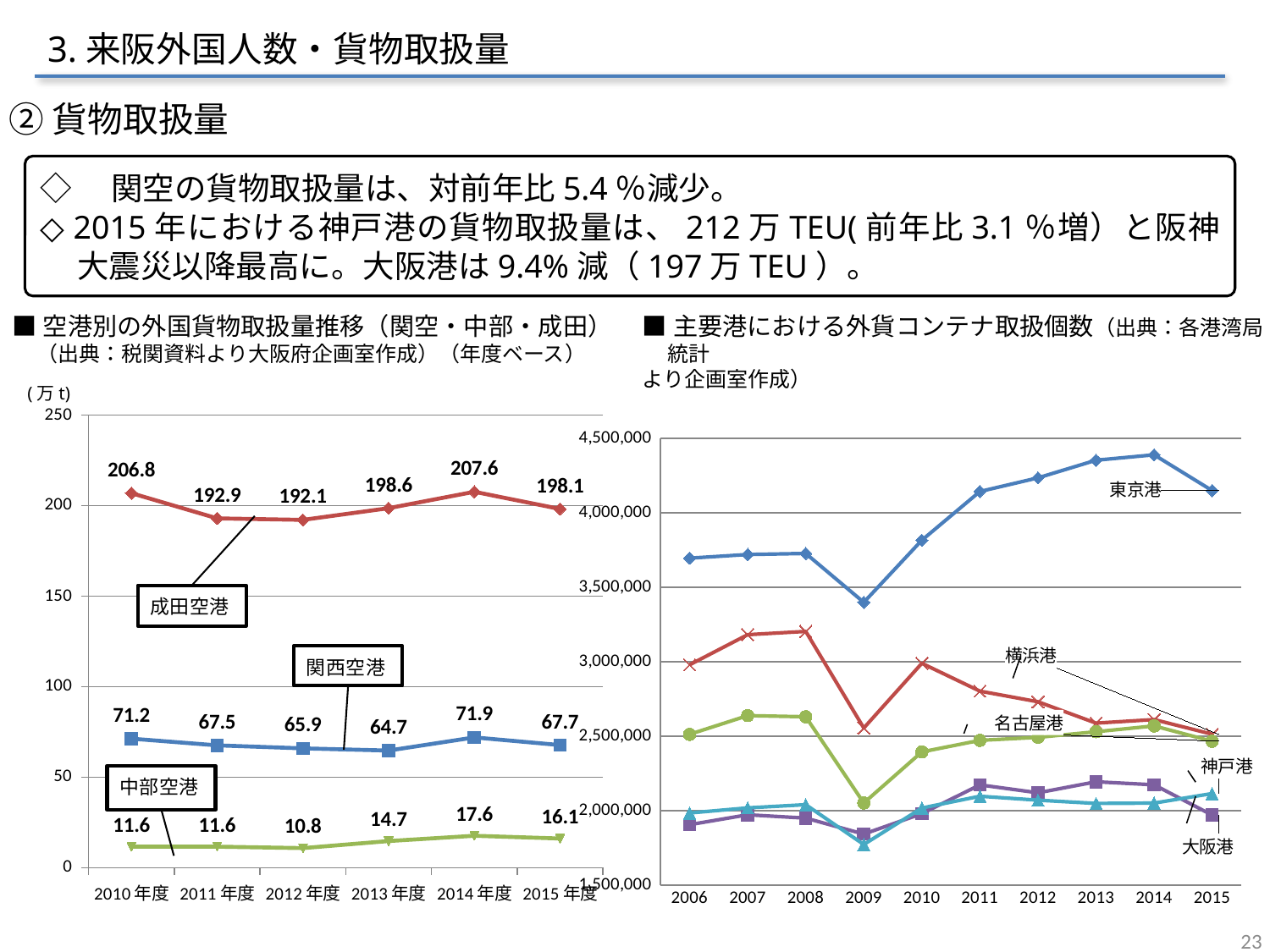
In the left chart (空港別の外国貨物取扱量推移), what is the value for 関西空港 in 2013年度? 64.7 In the right chart (主要港における外貨コンテナ取扱個数), which port has the highest value in 2015? 東京港 In the right chart (主要港における外貨コンテナ取扱個数), how many ports are plotted? 5 In the right chart (主要港における外貨コンテナ取扱個数), is the value for 東京港 in 2009 greater or less than 3,500,000? less In the left chart (空港別の外国貨物取扱量推移), what is the difference between the 成田空港 values for 2010年度 and 2011年度? 13.9 In the left chart (空港別の外国貨物取扱量推移), what type of chart is used? Line chart In the left chart (空港別の外国貨物取扱量推移), in which year is the value for 関西空港 lowest? 2013年度 In the right chart (主要港における外貨コンテナ取扱個数), is the value for 東京港 in 2015 greater or less than 4,000,000? greater In the left chart (空港別の外国貨物取扱量推移), how many years are shown on the x axis? 6 In the left chart (空港別の外国貨物取扱量推移), what is the value for 中部空港 in 2015年度? 16.1 In the left chart (空港別の外国貨物取扱量推移), in which year is the value for 中部空港 highest? 2014年度 In the left chart (空港別の外国貨物取扱量推移), what is the value for 成田空港 in 2014年度? 207.6